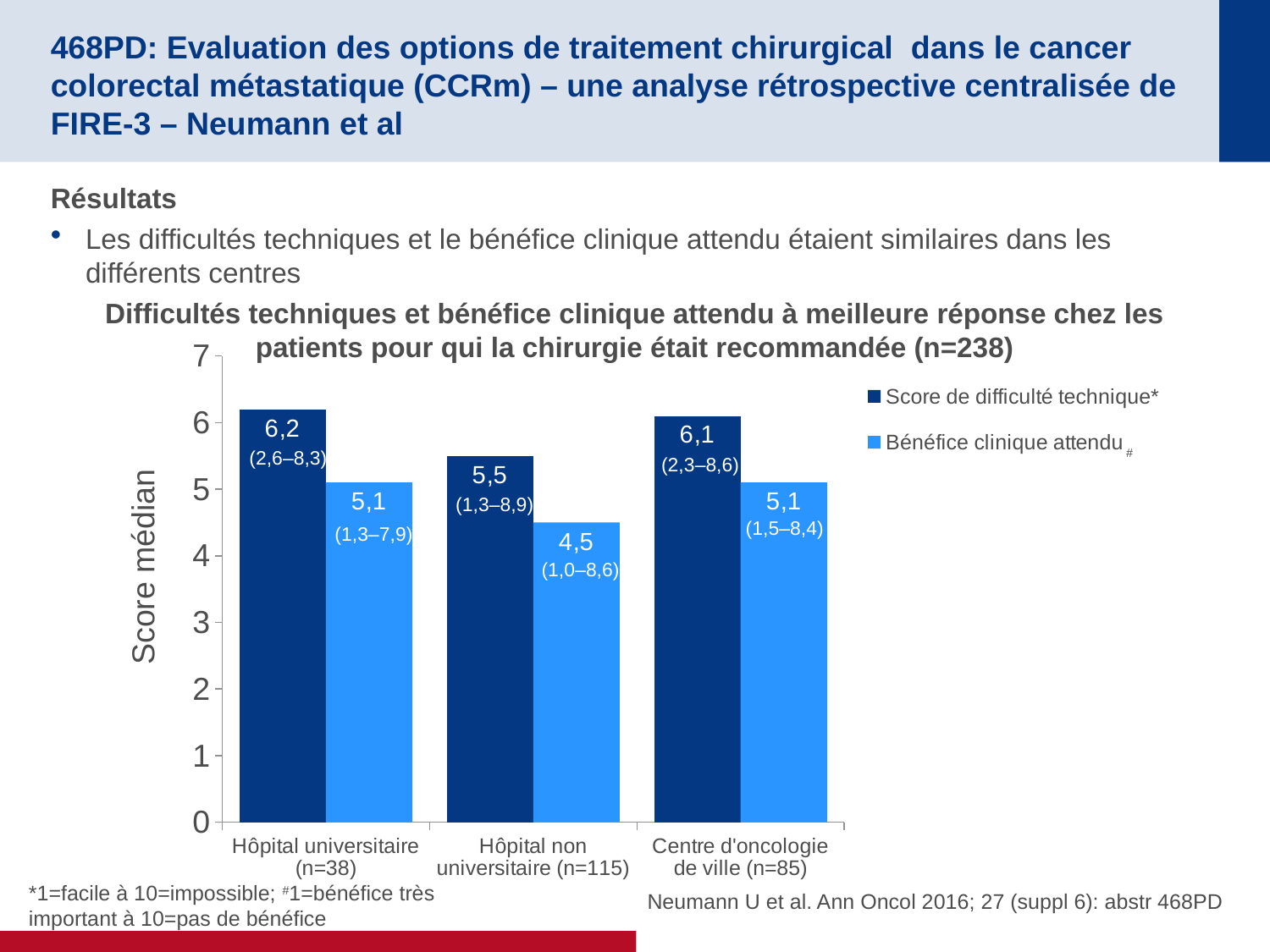
What is the median technical difficulty score (Score de difficulté technique) for Hôpital universitaire (n=38)? 6,2 What is the difference between the technical difficulty score and the expected clinical benefit score for Hôpital non universitaire (n=115)? 1,0 How many series does the chart legend list? 2 What type of chart is used to show the median scores? bar chart Is the expected clinical benefit score for Hôpital non universitaire (n=115) greater or less than 5? less How many centre types are shown on the x axis of the chart? 3 What is the median technical difficulty score for Centre d'oncologie de ville (n=85)? 6,1 What is the median expected clinical benefit score (Bénéfice clinique attendu) for Hôpital non universitaire (n=115)? 4,5 What is the label of the y axis of the chart? Score médian Is the technical difficulty score for Hôpital universitaire (n=38) higher or lower than its expected clinical benefit score? higher Which centre type has the highest median technical difficulty score? Hôpital universitaire (n=38) Which centre type has the lowest median expected clinical benefit score? Hôpital non universitaire (n=115)